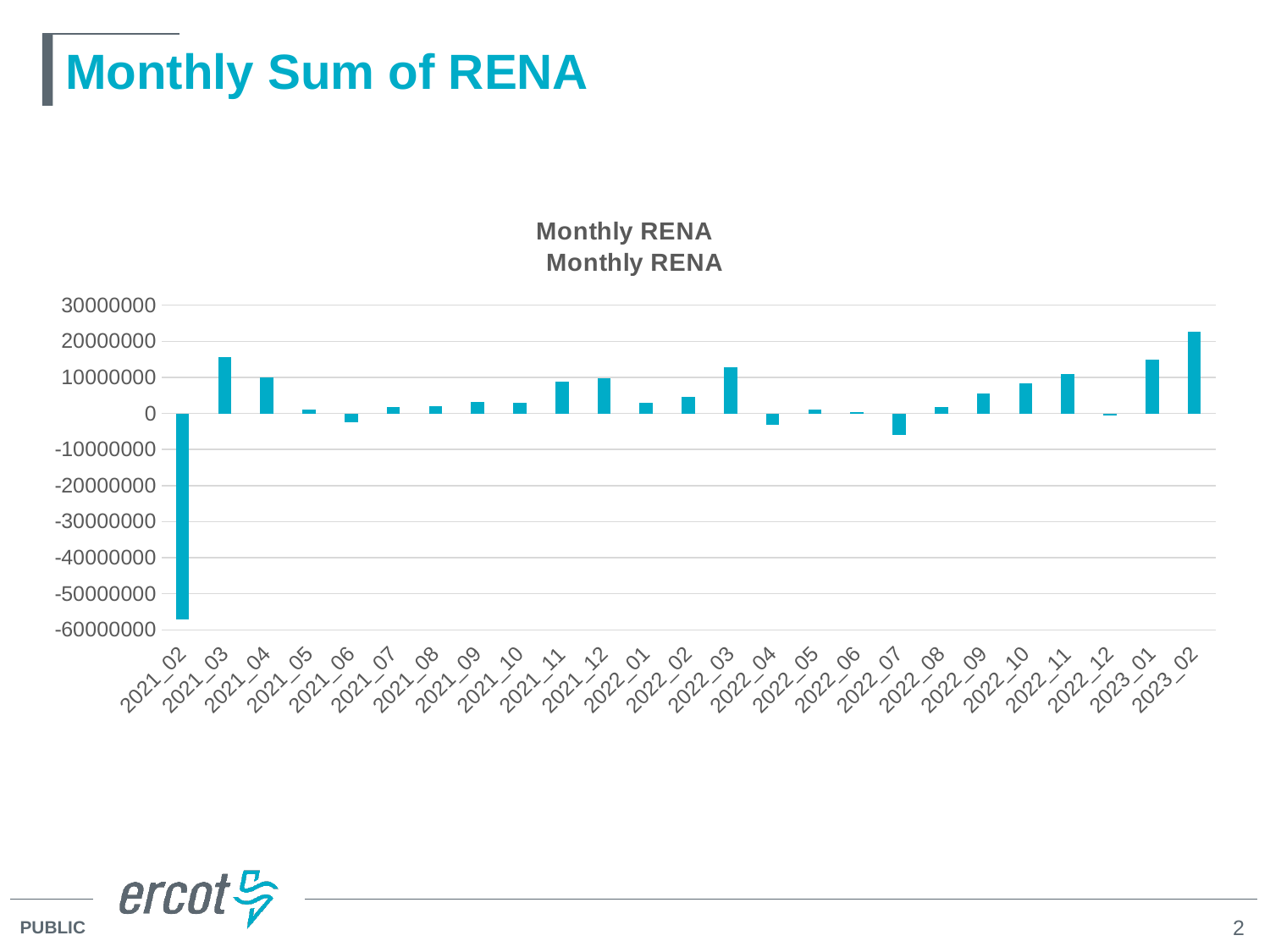
Which month has the lowest value? 2021_02 Is the value for 2021_03 greater or less than 10000000? greater What kind of chart is shown on the slide? bar chart What is the title of the chart? Monthly RENA Which month has the highest value? 2023_02 Which is larger, the value for 2023_01 or the value for 2023_02? 2023_02 What is the first month shown on the x axis? 2021_02 Is the value for 2022_07 greater or less than 0? less Is the value for 2021_02 greater or less than -50000000? less How many monthly categories are plotted on the x axis? 25 Which is larger, the value for 2022_03 or the value for 2022_04? 2022_03